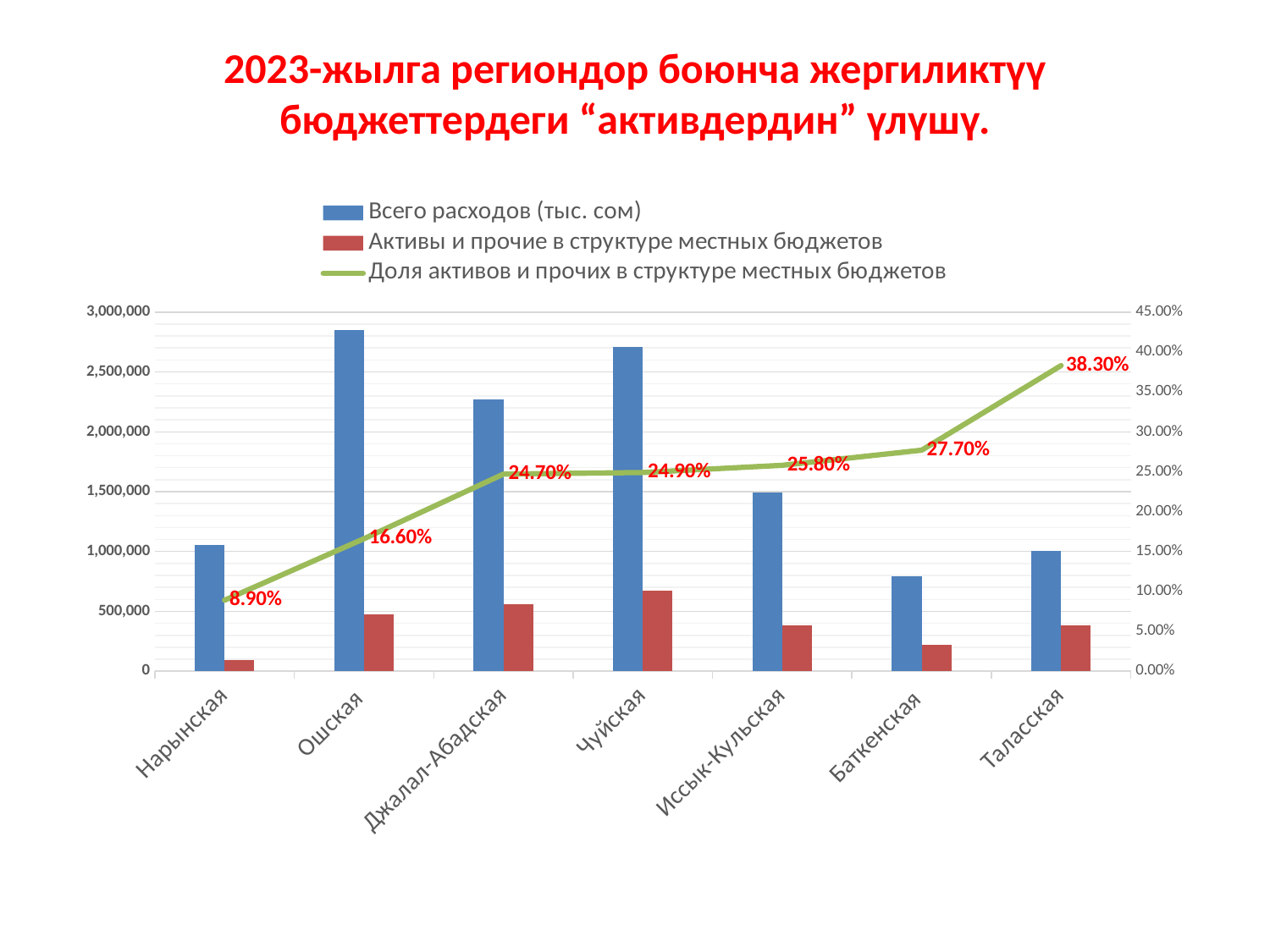
Is the value of 'Активы и прочие в структуре местных бюджетов' for Нарынская greater or less than 500,000? less Is the value of 'Всего расходов (тыс. сом)' for Ошская greater or less than 2,500,000? greater Which region has the tallest bar for 'Всего расходов (тыс. сом)'? Ошская Which region has the shortest bar for 'Всего расходов (тыс. сом)'? Баткенская What is the value of the line series 'Доля активов и прочих в структуре местных бюджетов' for Нарынская? 8.90% What is the value of the line series 'Доля активов и прочих в структуре местных бюджетов' for Таласская? 38.30% What is the value of the line series 'Доля активов и прочих в структуре местных бюджетов' for Чуйская? 24.90% How many series does the legend list? 3 Which region has the highest value on the line series 'Доля активов и прочих в структуре местных бюджетов'? Таласская Which region has the lowest value on the line series 'Доля активов и прочих в структуре местных бюджетов'? Нарынская How many regions are shown on the x axis? 7 What is the difference between the line values for Таласская and Нарынская? 29.40%